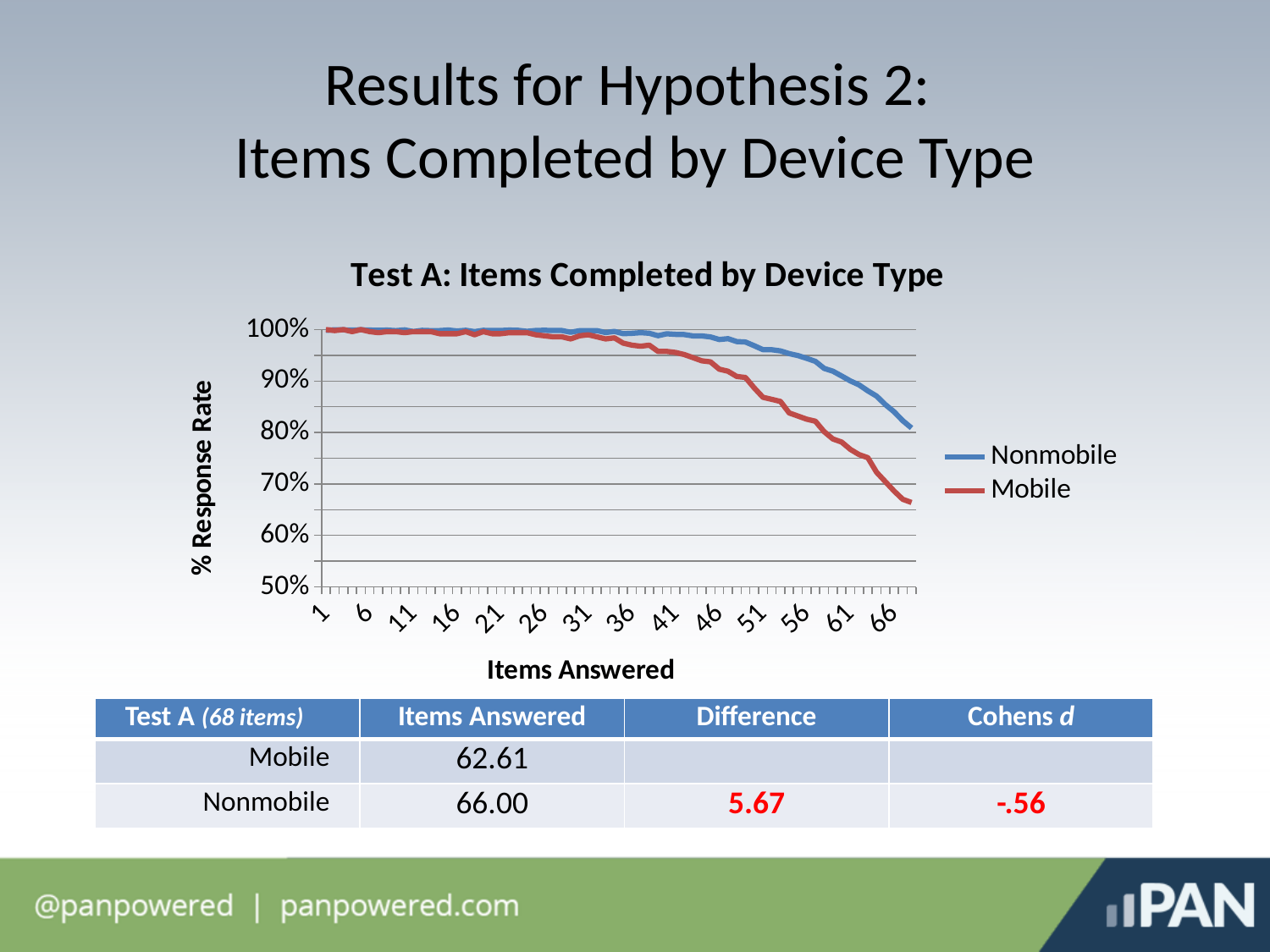
Is the Mobile response rate at item 41 greater or less than 90%? greater What is the label on the chart's vertical axis? % Response Rate How many series does the chart's legend list? 2 What is the title of the chart? Test A: Items Completed by Device Type What kind of chart is shown on the slide? line chart Which series reaches the lowest response rate on the chart? Mobile At item 56, which series has the lower response rate, Nonmobile or Mobile? Mobile Is the Mobile response rate at the last item answered greater or less than 70%? less Is the Nonmobile response rate at item 46 greater or less than 90%? greater Do the response rates rise or fall as the number of items answered increases? fall At the last item answered, which series has the higher response rate, Nonmobile or Mobile? Nonmobile